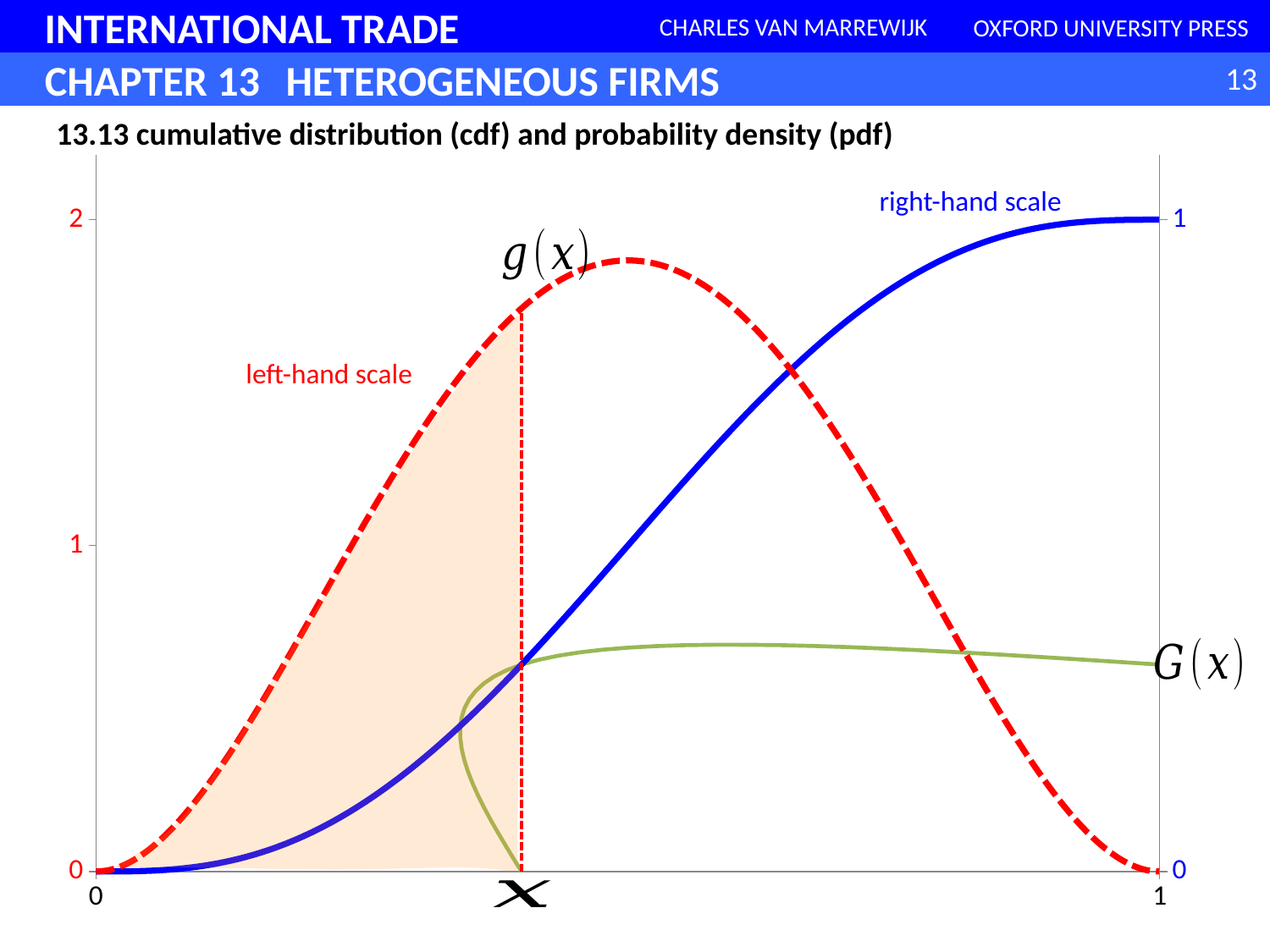
What is the value of G(x) at x = 1 on the right-hand scale? 1 Does G(x) rise or fall as x increases from 0 to 1? rise What is the highest tick value shown on the left-hand scale? 2 What kind of chart is shown on the slide? line chart What is the value of G(x) at x = 0 on the right-hand scale? 0 What is the title of the chart? 13.13 cumulative distribution (cdf) and probability density (pdf) How many curves (functions) are plotted on the chart? 3 Which curve is plotted against the right-hand scale? G(x) Is the peak value of g(x) greater or less than 1 on the left-hand scale? greater Is the value of g(x) at the marked point x greater or less than 1 on the left-hand scale? greater Is the peak value of g(x) greater or less than 2 on the left-hand scale? less What is the value of g(x) at x = 1 on the left-hand scale? 0